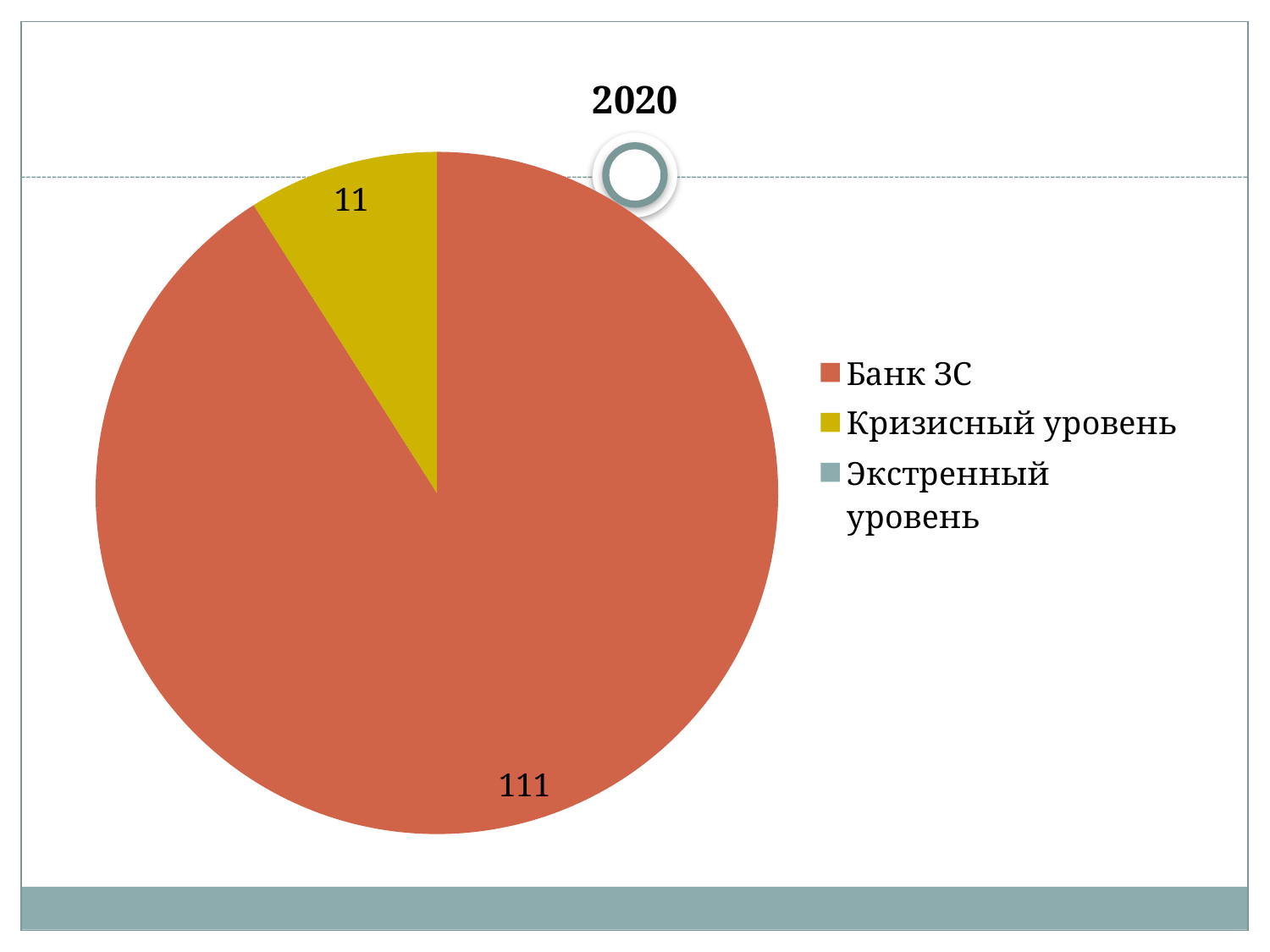
What type of chart is shown on the slide? pie chart Which category has the largest slice of the pie? Банк ЗС How many slices with data labels are visible in the pie? 2 Is the value for Банк ЗС larger or smaller than the value for Кризисный уровень? larger What colour is the slice for Кризисный уровень? yellow Which of the two labelled slices is smaller, Банк ЗС or Кризисный уровень? Кризисный уровень What is the value for Банк ЗС? 111 How many entries does the legend list? 3 What is the difference between the values for Банк ЗС and Кризисный уровень? 100 What is the title of the chart? 2020 What is the value for Кризисный уровень? 11